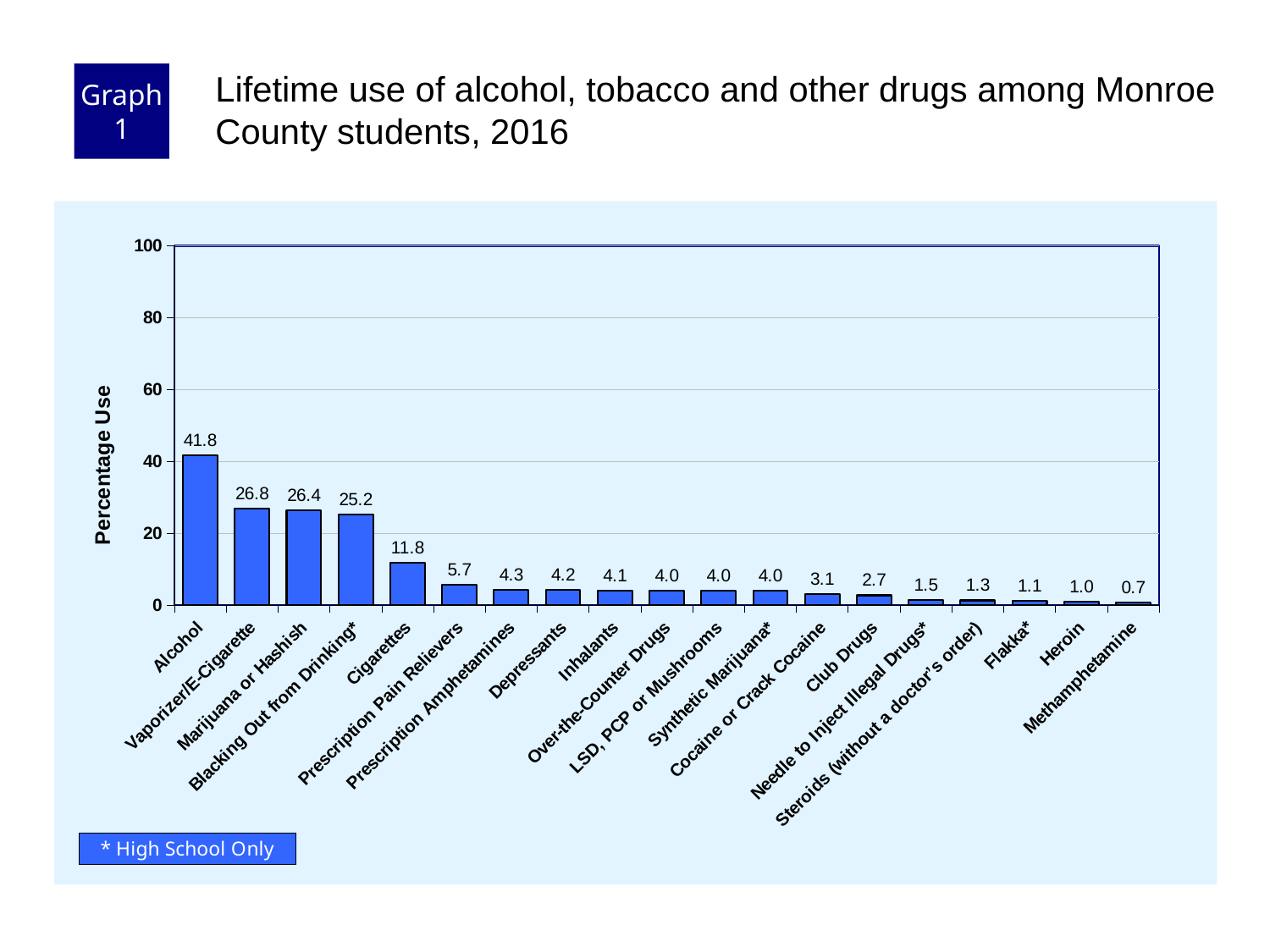
Do the values rise or fall moving from left to right along the x axis? Fall Which is larger, the value for Cigarettes or the value for Prescription Pain Relievers? Cigarettes What is the percentage use value for Cigarettes? 11.8 Which category has the highest percentage use? Alcohol What kind of chart is shown on the slide? Bar chart How many categories are shown on the x axis? 19 What is the percentage use value for Alcohol? 41.8 Is the value for Alcohol greater or less than 40? greater What is the percentage use value for Heroin? 1.0 What is the difference between the values for Alcohol and Vaporizer/E-Cigarette? 15.0 Which category has the lowest percentage use? Methamphetamine What is the label of the y axis? Percentage Use